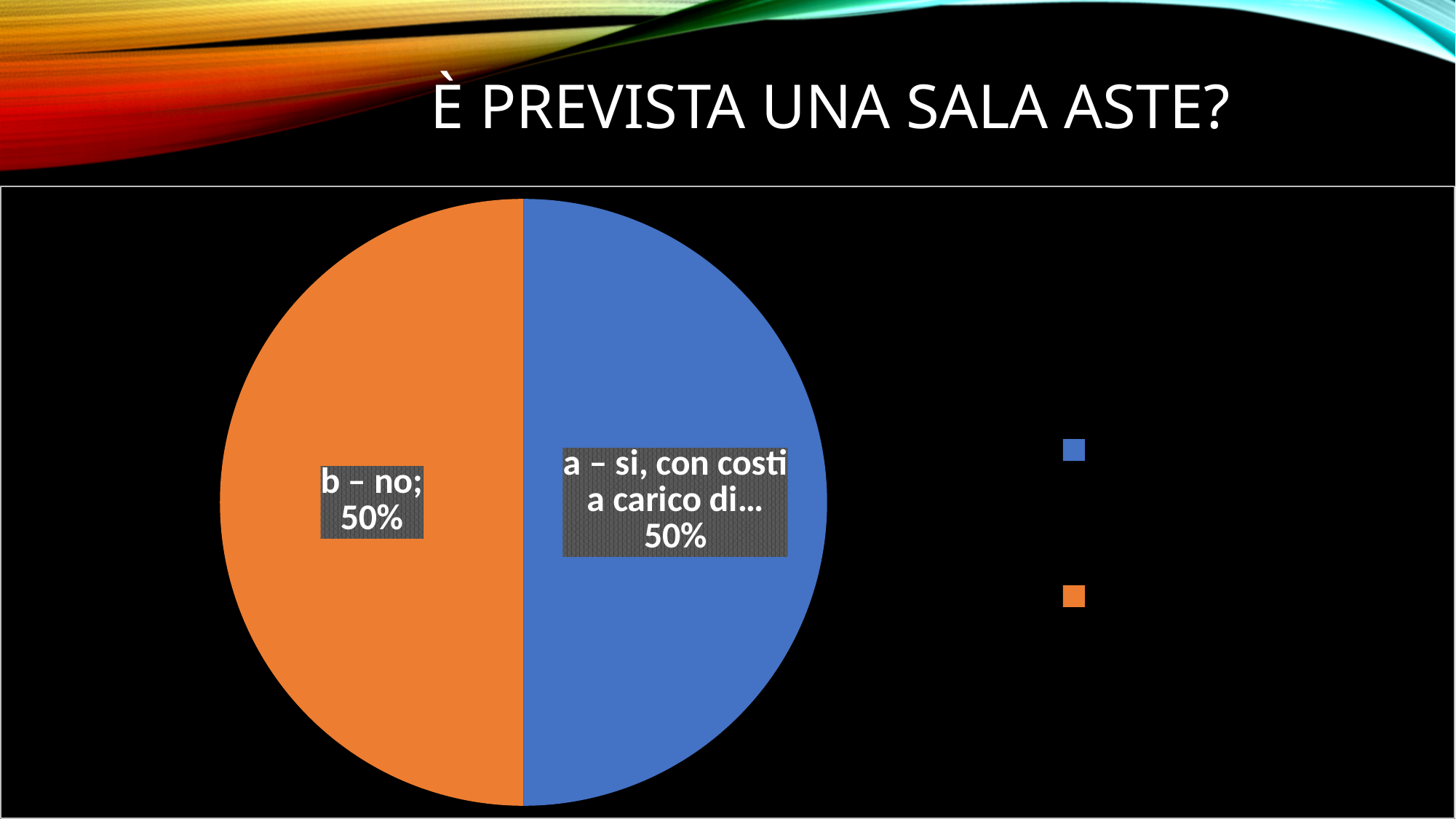
What colour is the slice labelled "b – no"? orange What is the difference between the share for "b – no" and the share for "a – si, con costi a carico di…"? 0% Is the slice for "b – no" larger than, smaller than, or equal to the slice for "a – si, con costi a carico di…"? equal What kind of chart is shown on the slide? pie chart What share of the pie does the slice labelled "a – si, con costi a carico di…" represent? 50% How many slices does the pie chart have? 2 What is the value printed on the orange slice of the pie chart? 50% What is the title of the slide containing the pie chart? È PREVISTA UNA SALA ASTE? What share of the pie does the slice labelled "b – no" represent? 50% What is the value printed on the blue slice of the pie chart? 50%